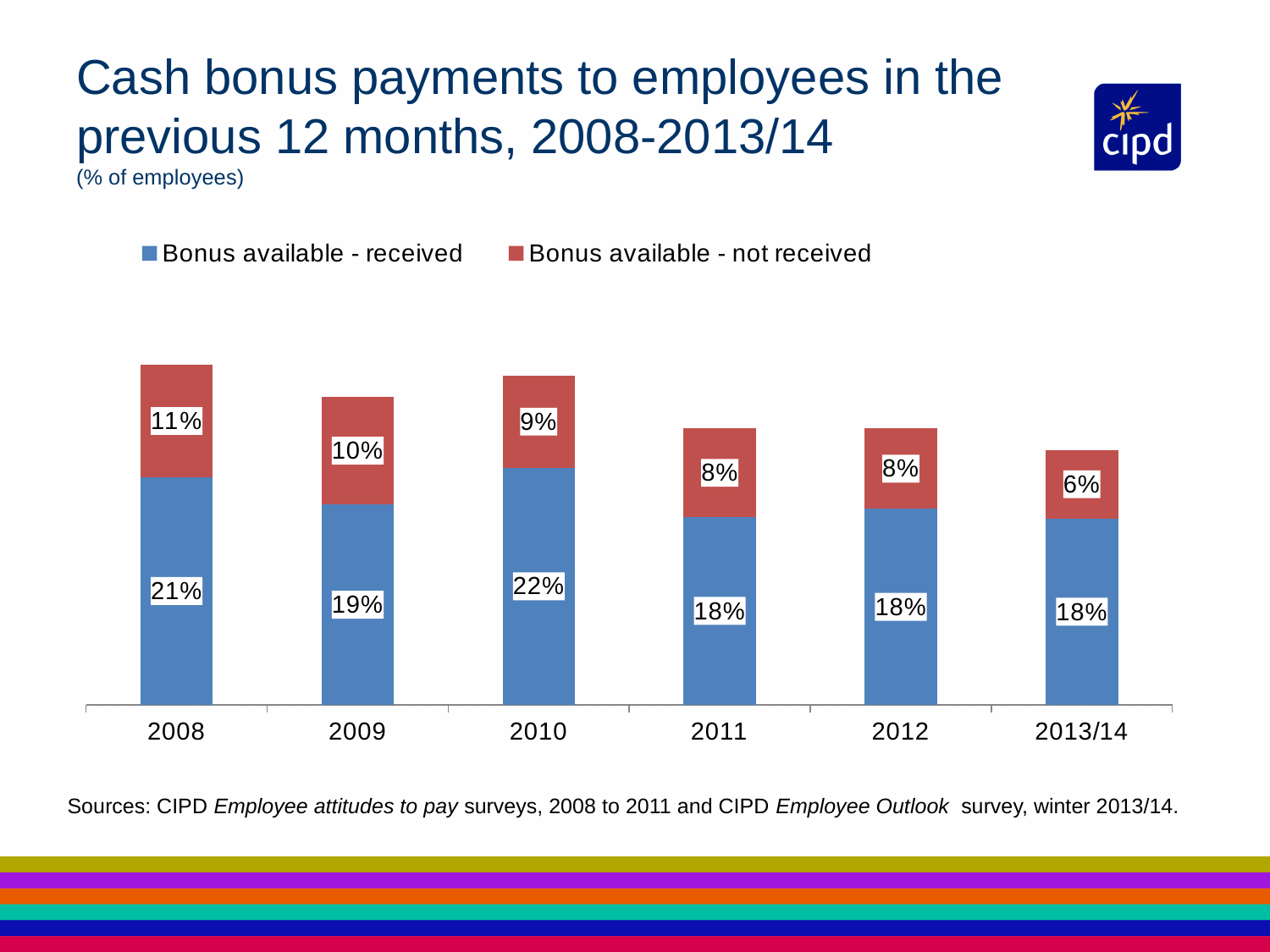
In which year was the 'Bonus available - received' share highest? 2010 What percentage of employees had a bonus available but did not receive it in 2013/14? 6% How many series does the legend list? 2 Which is larger: the 'Bonus available - not received' value in 2009 or in 2011? 2009 In which year was the 'Bonus available - not received' share lowest? 2013/14 What is the difference between the 'Bonus available - received' values for 2008 and 2009? 2% What is the value for 'Bonus available - not received' in 2008? 11% What percentage of employees had a bonus available and received it in 2010? 22% What is the total of the stacked bar for 2013/14? 24% What kind of chart is shown on the slide? Stacked bar chart What is the total of the stacked bar for 2008? 32% How many years are shown on the x axis? 6